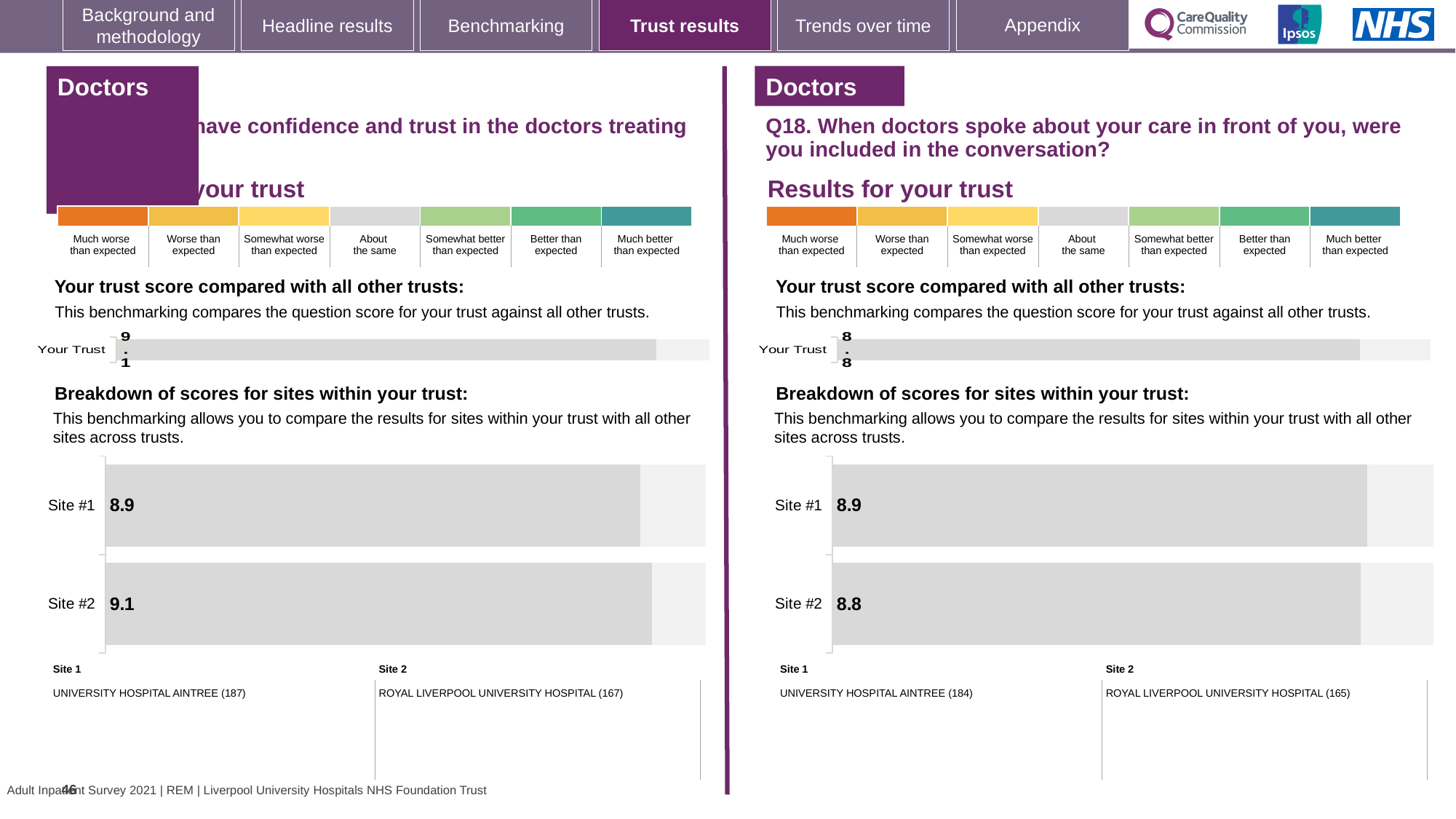
How many sites are shown in the left-hand site breakdown chart? 2 In the Q18 site breakdown chart on the right, what is the score for Site #2? 8.8 In the left-hand site breakdown chart, what is the score for Site #1? 8.9 On the right-hand side of the slide (Q18), what is the score shown for Your Trust in the trust comparison chart? 8.8 In the left-hand site breakdown chart, what is the score for Site #2? 9.1 On the left-hand side of the slide, what is the score shown for Your Trust in the trust comparison chart? 9.1 In the left-hand site breakdown chart, which site has the higher score? Site #2 What type of chart is used for the site breakdown on the right-hand side of the slide? Bar chart In the left-hand site breakdown chart, what is the difference between the Site #2 and Site #1 scores? 0.2 In the Q18 site breakdown chart on the right, which site has the lower score? Site #2 In the Q18 site breakdown chart on the right, what is the score for Site #1? 8.9 In the Q18 site breakdown chart on the right, what is the difference between the Site #1 and Site #2 scores? 0.1